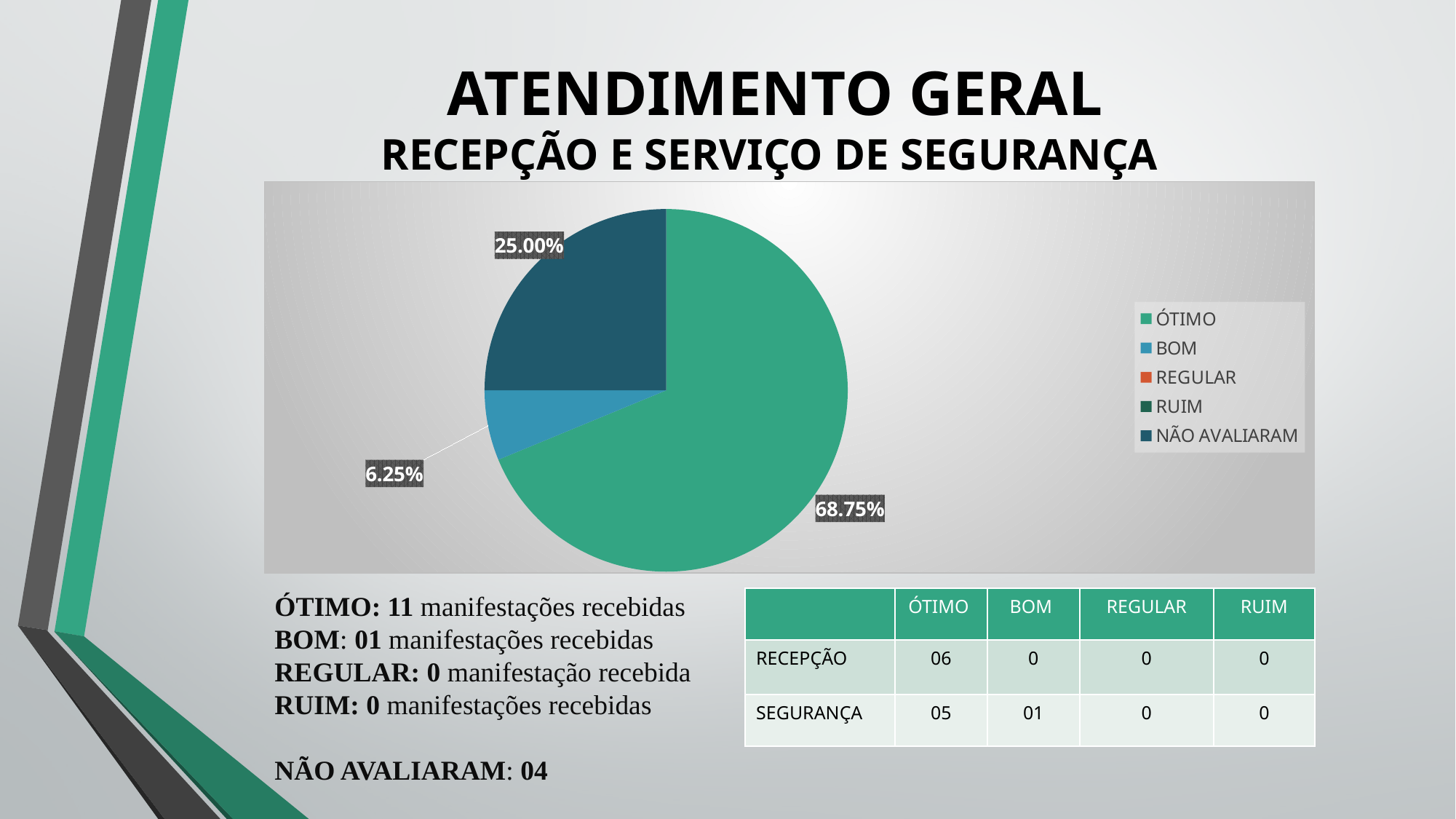
Which slice has the smallest percentage label shown on the pie chart? BOM How many entries does the pie chart's legend list? 5 Which category has the largest slice in the pie chart? ÓTIMO What is the difference in percentage points between the NÃO AVALIARAM slice and the BOM slice? 18.75 How many slices with percentage labels are visible in the pie chart? 3 What colour is the ÓTIMO slice in the pie chart? green Which slice is larger in the pie chart, BOM or NÃO AVALIARAM? NÃO AVALIARAM What type of chart is shown on the slide? pie chart What percentage does the BOM slice of the pie chart represent? 6.25% What is the difference in percentage points between the ÓTIMO slice and the NÃO AVALIARAM slice? 43.75 What percentage does the NÃO AVALIARAM slice of the pie chart represent? 25.00% What percentage does the ÓTIMO slice of the pie chart represent? 68.75%